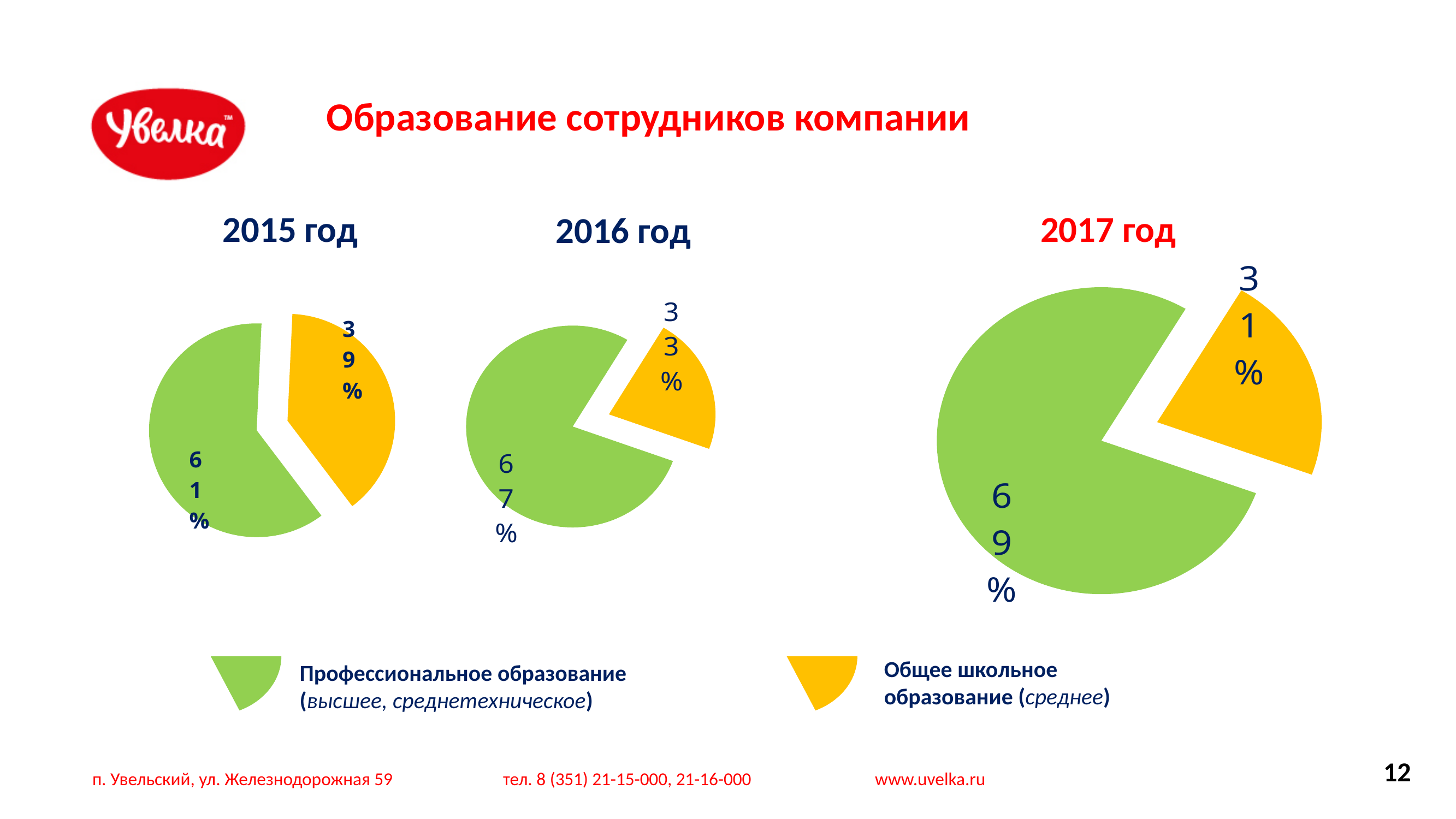
Какая доля сотрудников с общим школьным образованием показана на диаграмме «2015 год»? 39% Какая доля сотрудников с общим школьным образованием показана на диаграмме «2016 год»? 33% На диаграмме «2015 год» на сколько процентных пунктов доля профессионального образования больше доли общего школьного образования? 22 На диаграмме «2016 год» какая категория занимает наименьшую долю? Общее школьное образование Какая доля сотрудников с профессиональным образованием показана на диаграмме «2015 год»? 61% Сколько секторов на диаграмме «2015 год»? 2 Как меняется доля профессионального образования с 2015 по 2017 год? Растёт Какая доля сотрудников с профессиональным образованием показана на диаграмме «2017 год»? 69% Каким цветом на диаграммах обозначено общее школьное образование? Жёлтым Какая доля больше: профессиональное образование на диаграмме «2016 год» или на диаграмме «2017 год»? 2017 год На диаграмме «2017 год» какая категория занимает наибольшую долю? Профессиональное образование Какого типа диаграммы показаны на слайде? Круговые диаграммы